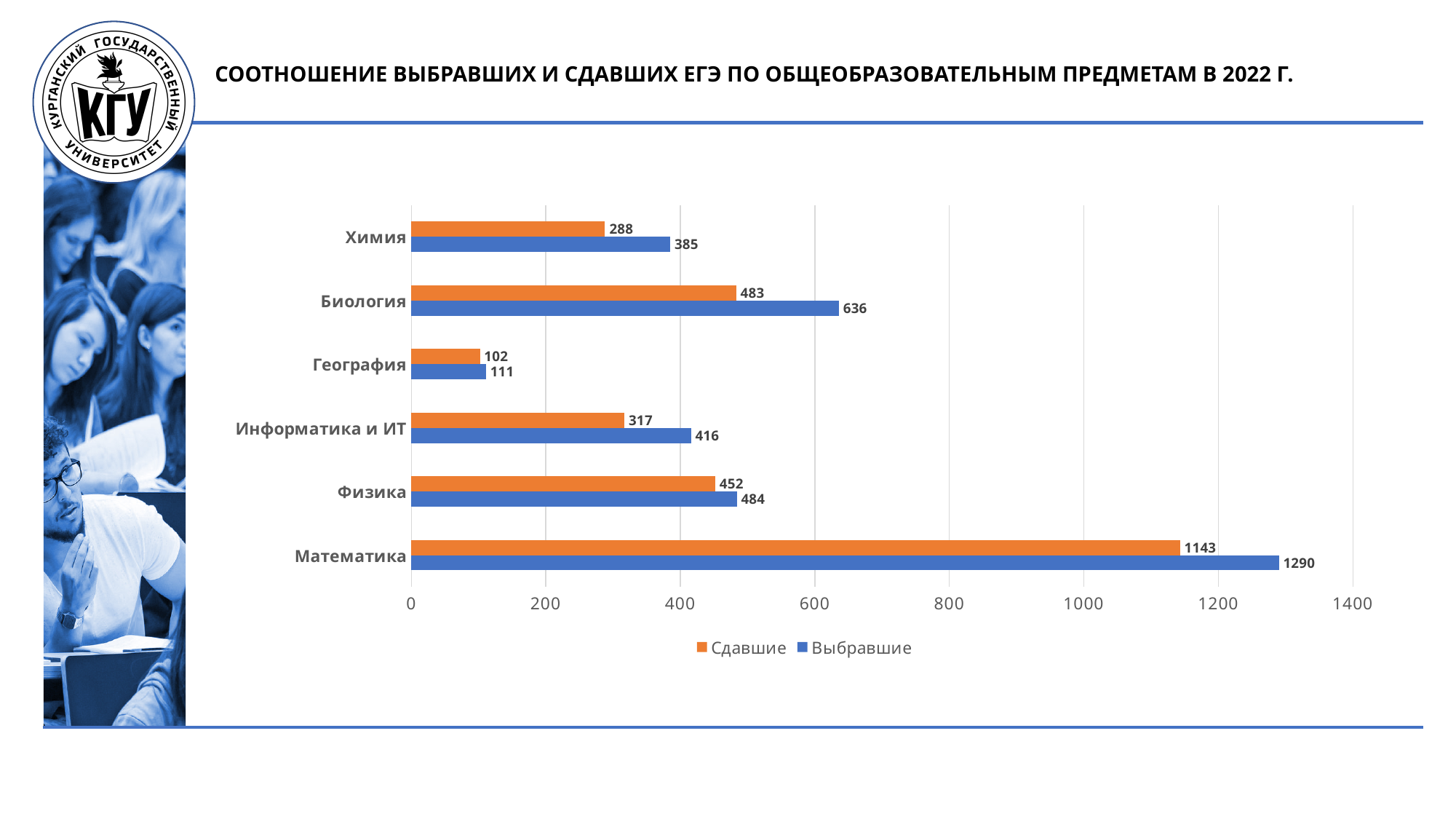
Which subject has the highest value for Выбравшие? Математика What is the value of Выбравшие for Математика? 1290 What is the difference between Выбравшие and Сдавшие for Математика? 147 How many series does the legend list? 2 Which is larger: Сдавшие for Биология or Сдавшие for Физика? Сдавшие for Биология Which subject has the lowest value for Сдавшие? География What is the difference between Выбравшие and Сдавшие for Физика? 32 How many subjects are shown on the chart? 6 What kind of chart is shown on the slide? Bar chart Is the value of Выбравшие for Информатика и ИТ greater or less than 400? greater What is the value of Сдавшие for Химия? 288 What is the value of Выбравшие for Биология? 636